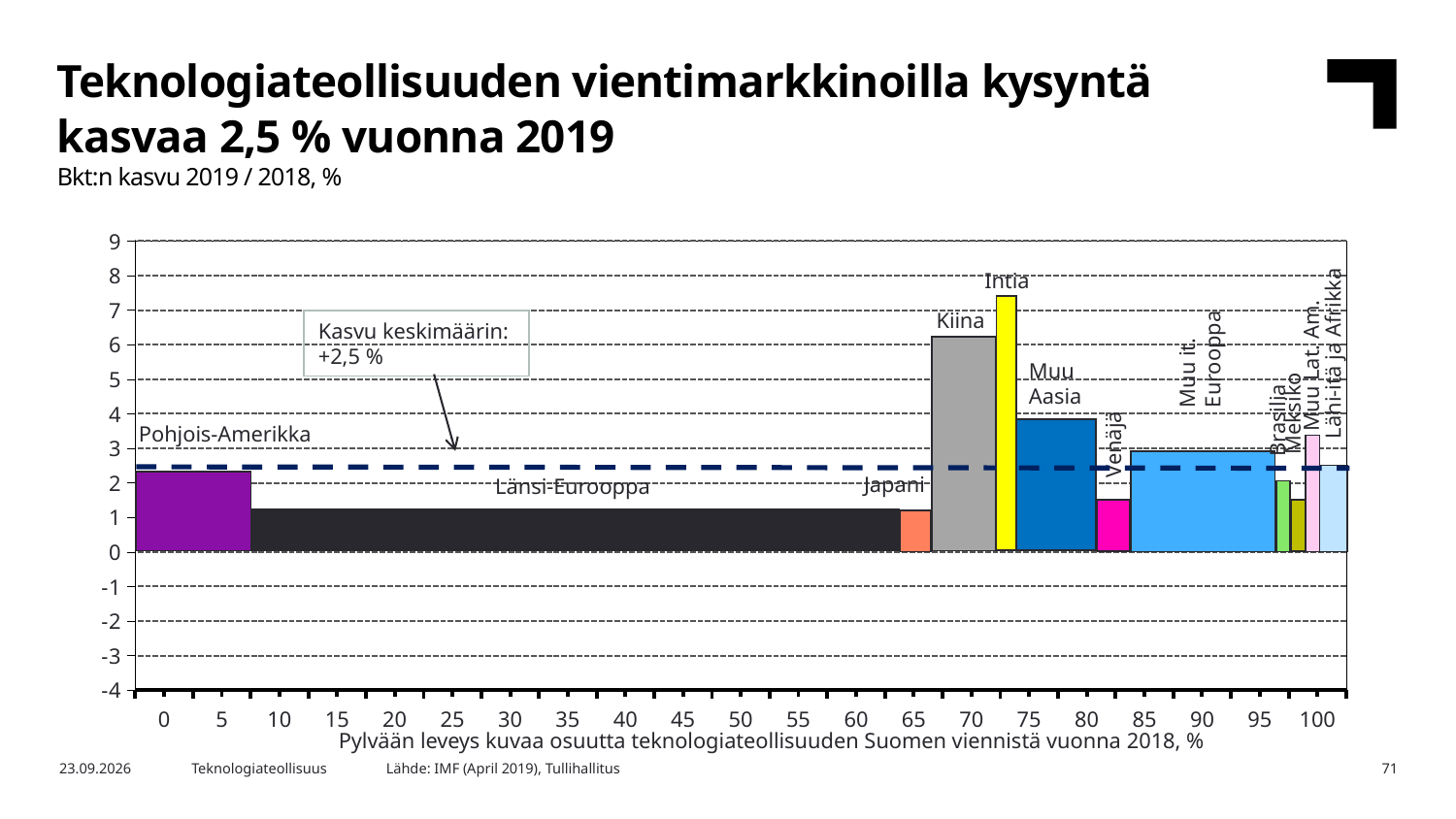
Is the value for Kiina greater or less than 5? greater How many regions are shown as bars in the chart? 12 Which region has the highest GDP growth in the chart? Intia Which has the larger value, Intia or Kiina? Intia What average growth does the dashed line annotation state? +2,5 % What kind of chart is shown on the slide? bar chart Is the value for Venäjä greater or less than 2? less Is the value for Muu Aasia greater or less than 3? greater Which has the larger value, Kiina or Muu Aasia? Kiina